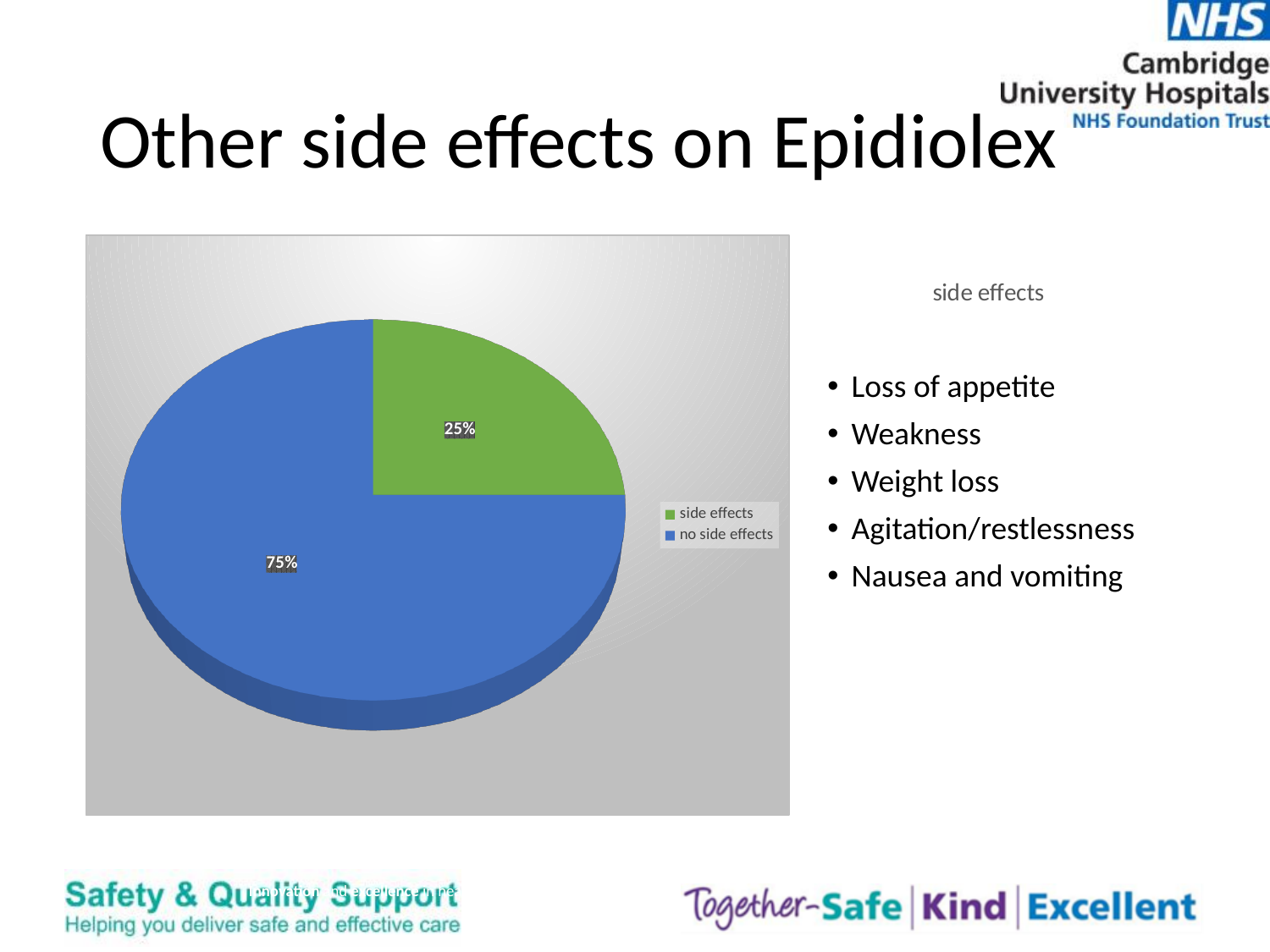
What colour is the "no side effects" slice? blue What kind of chart is shown on the slide? pie chart Which slice of the pie is the smallest? side effects What share of the pie is labelled "no side effects"? 75% What colour is the "side effects" slice? green What share of the pie is labelled "side effects"? 25% How many entries does the legend list? 2 Which slice of the pie is the largest? no side effects How many slices does the pie chart have? 2 Which is larger, the "side effects" slice or the "no side effects" slice? no side effects What is the difference in percentage points between the "no side effects" slice and the "side effects" slice? 50 percentage points